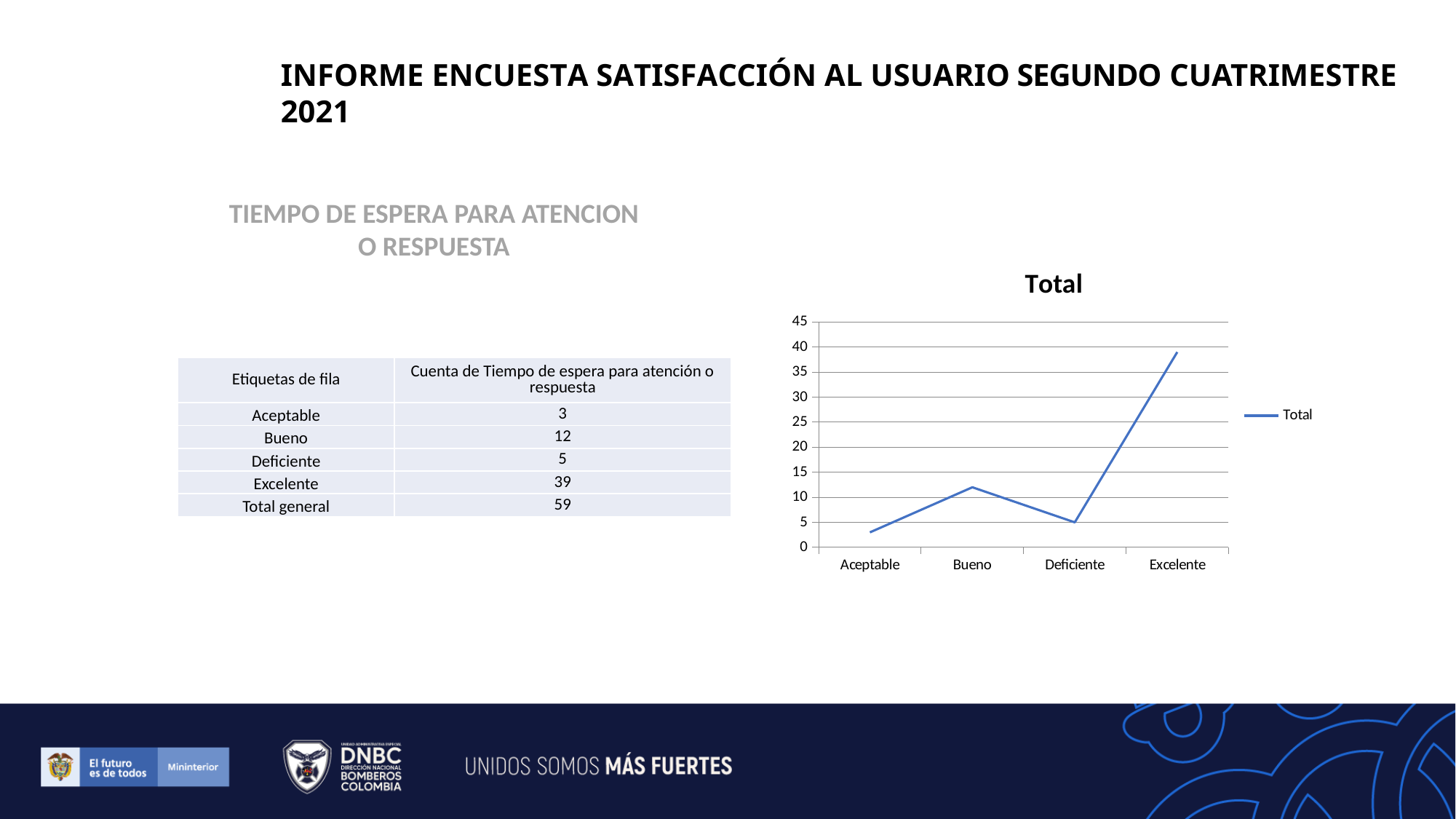
How many categories are plotted along the x axis of the chart? 4 According to the table on the slide, what is the difference between the values for Excelente and Bueno? 27 Is the value for Excelente greater or less than 35? greater What kind of chart is shown on the slide? line chart How many series does the chart legend list? 1 Which has a larger value, Bueno or Deficiente? Bueno According to the table on the slide, what is the value for Excelente? 39 Which category has the highest value in the chart? Excelente Is the value for Bueno greater or less than 10? greater Is the value for Deficiente greater or less than 10? less What is the title of the chart? Total Which category has the lowest value in the chart? Aceptable